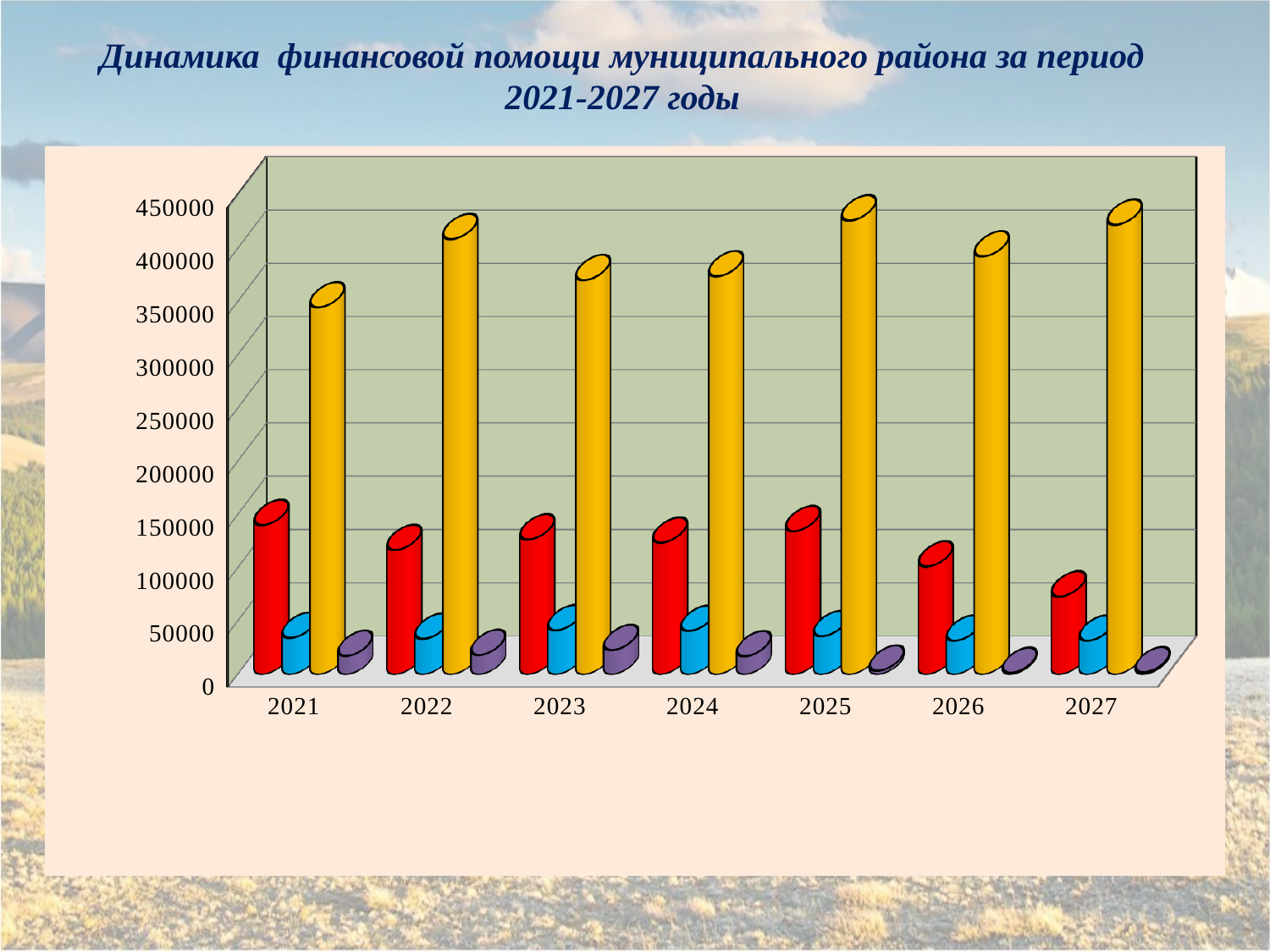
What is the title of the chart on the slide? Динамика финансовой помощи муниципального района за период 2021-2027 годы Which is larger, the yellow bar for 2025 or the yellow bar for 2026? 2025 Which colour of bar is the tallest in every year? yellow What kind of chart is shown on the slide? bar chart Is the value of the yellow bar for 2021 greater or less than 400000? less In which year is the yellow bar the lowest? 2021 In which year is the red bar the lowest? 2027 Do the red bars rise or fall from 2025 to 2027? fall Is the value of the red bar for 2021 greater or less than 100000? greater How many series (bar colours) are plotted for each year? 4 How many years are shown on the x axis of the chart? 7 Is the value of the yellow bar for 2022 greater or less than 400000? greater